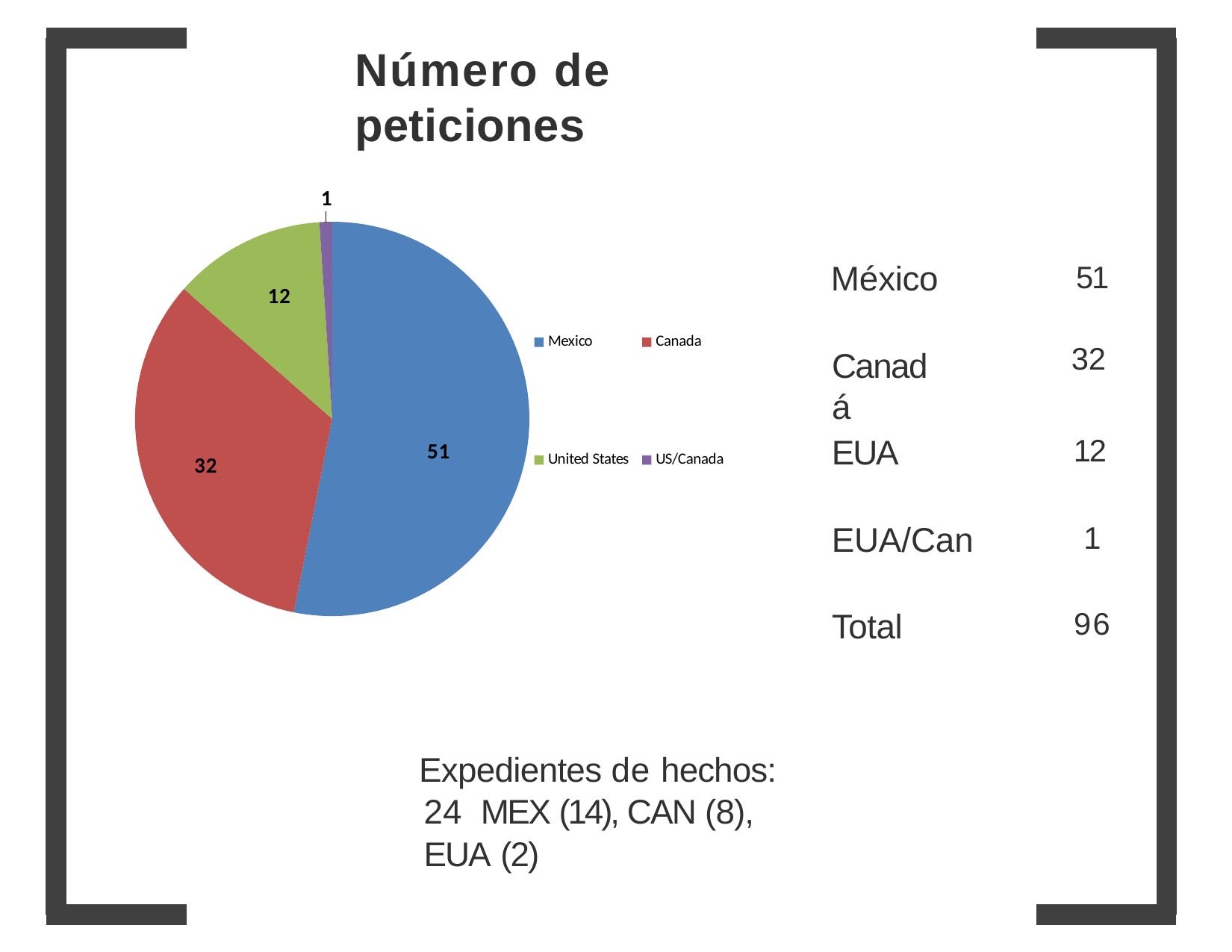
Which category has the smallest slice of the pie chart? US/Canada What is the value for US/Canada in the pie chart? 1 What is the value for Canada in the pie chart? 32 How many categories does the pie chart show? 4 Which is larger, the value for Canada or the value for United States? Canada What is the value for United States in the pie chart? 12 What type of chart is shown on the slide? pie chart What share of the pie does Mexico represent, given the total of 96? 53.1% What is the value for Mexico in the pie chart? 51 What is the title of the chart? Número de peticiones Which category has the largest slice of the pie chart? Mexico What is the difference between the values for Mexico and Canada? 19